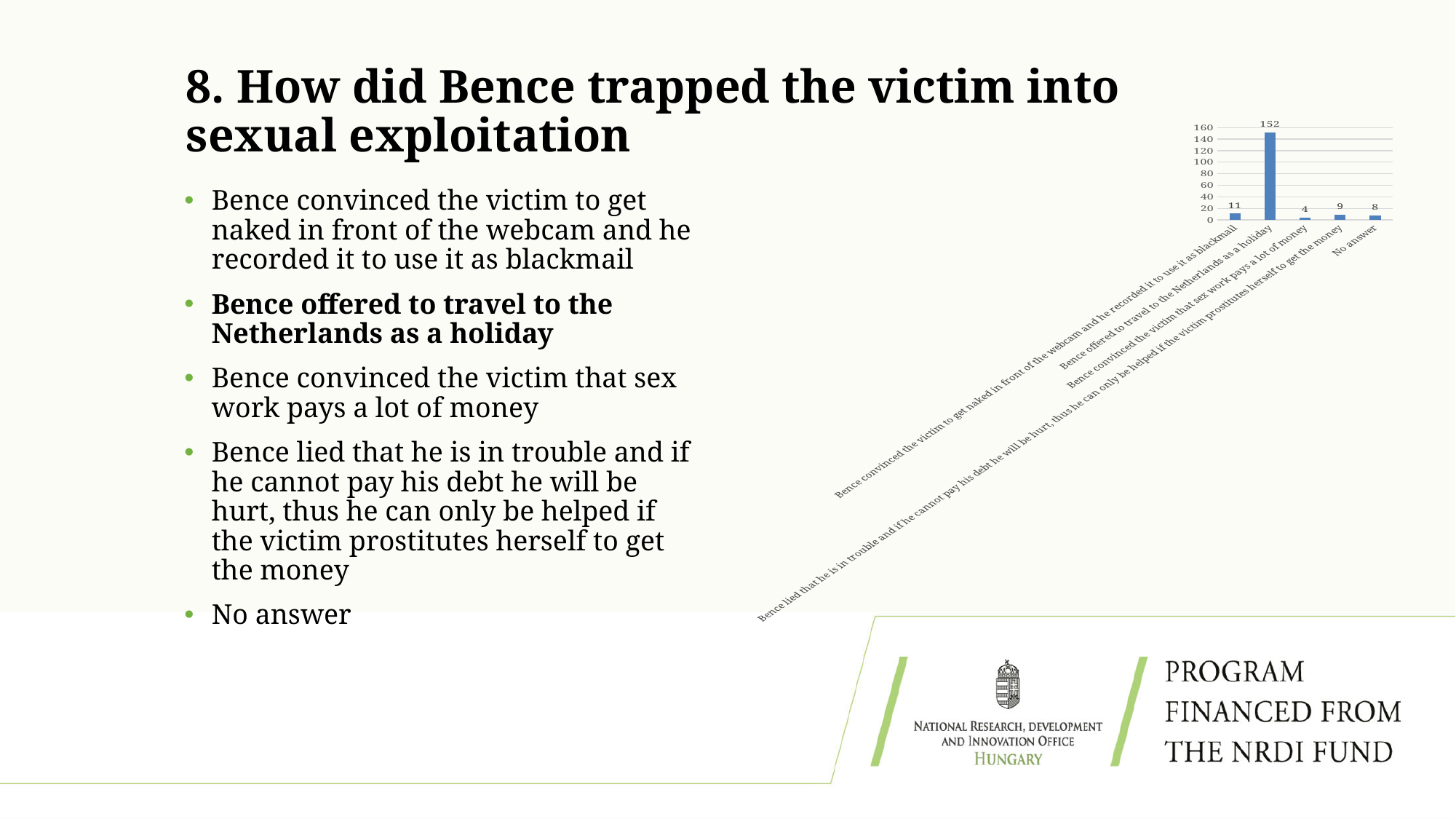
What is the value for "Bence convinced the victim that sex work pays a lot of money"? 4 What is the value for "No answer"? 8 What is the value for the category about Bence lying that he is in trouble and cannot pay his debt? 9 What kind of chart is shown on the slide? Bar chart Which category has the lowest value? Bence convinced the victim that sex work pays a lot of money How many categories does the chart show? 5 Which category has the highest value? Bence offered to travel to the Netherlands as a holiday What is the difference between the value for "Bence offered to travel to the Netherlands as a holiday" and the value for "No answer"? 144 What is the value for the category about Bence convincing the victim to get naked in front of the webcam and recording it as blackmail? 11 What is the value for "Bence offered to travel to the Netherlands as a holiday"? 152 What is the highest tick value shown on the vertical axis? 160 Which is larger: the value for the webcam blackmail category or the value for "No answer"? The webcam blackmail category